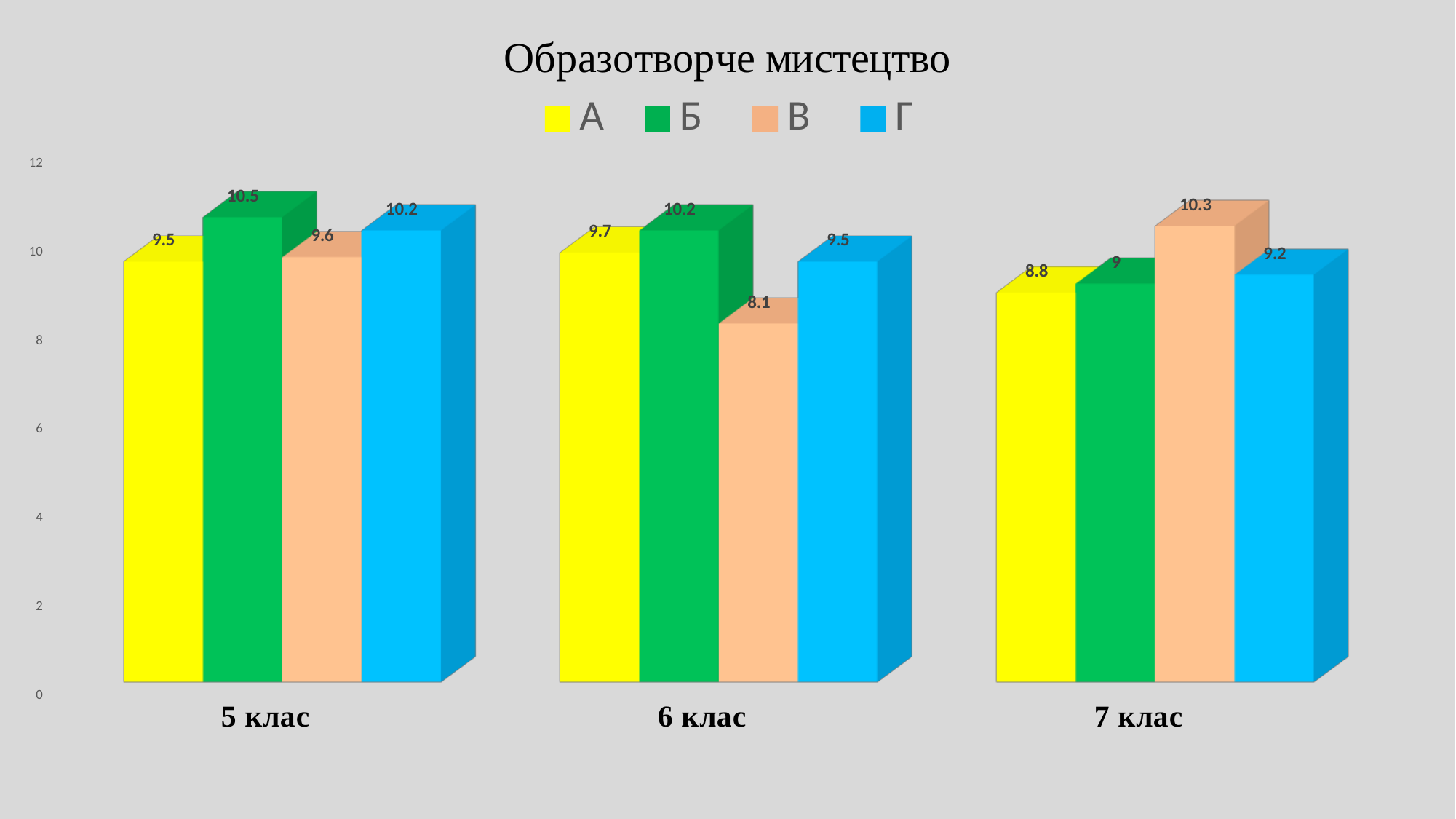
Which series has the highest value in 7 клас? В Which series has the lowest value in 6 клас? В What is the value for series В in 6 клас? 8.1 How many series does the legend list? 4 What is the value for series А in 7 клас? 8.8 What is the difference between series Б and series А in 5 клас? 1 What is the title of the chart? Образотворче мистецтво Which is larger in 6 клас: series А or series Б? Б What is the value for series Б in 5 клас? 10.5 What kind of chart is shown on the slide? bar chart What is the value for series Г in 6 клас? 9.5 How many categories are shown on the x axis? 3